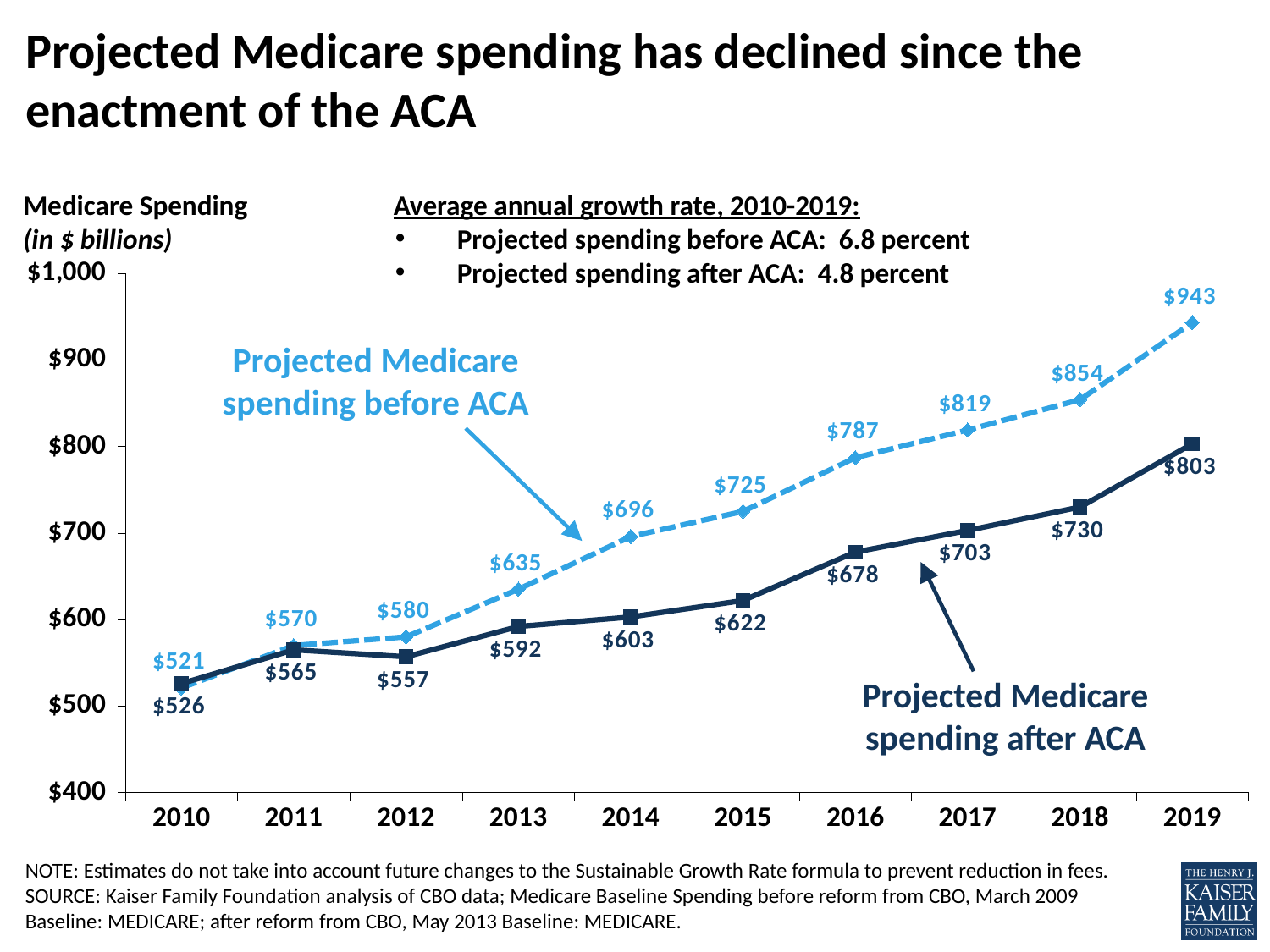
How many years are shown on the x axis? 10 What is the projected Medicare spending after ACA in 2016? $678 Does projected Medicare spending after ACA rise or fall from 2010 to 2019? Rise What is the difference between projected spending before ACA and after ACA in 2017? $116 What is the projected Medicare spending before ACA in 2019? $943 Which is larger in 2011: projected spending before ACA or after ACA? Projected spending before ACA In which year is projected Medicare spending before ACA lowest? 2010 What is the difference between projected spending before ACA and after ACA in 2019? $140 In which year is projected Medicare spending after ACA highest? 2019 What is the projected Medicare spending before ACA in 2014? $696 What is the projected Medicare spending after ACA in 2012? $557 What kind of chart is shown on the slide? Line chart